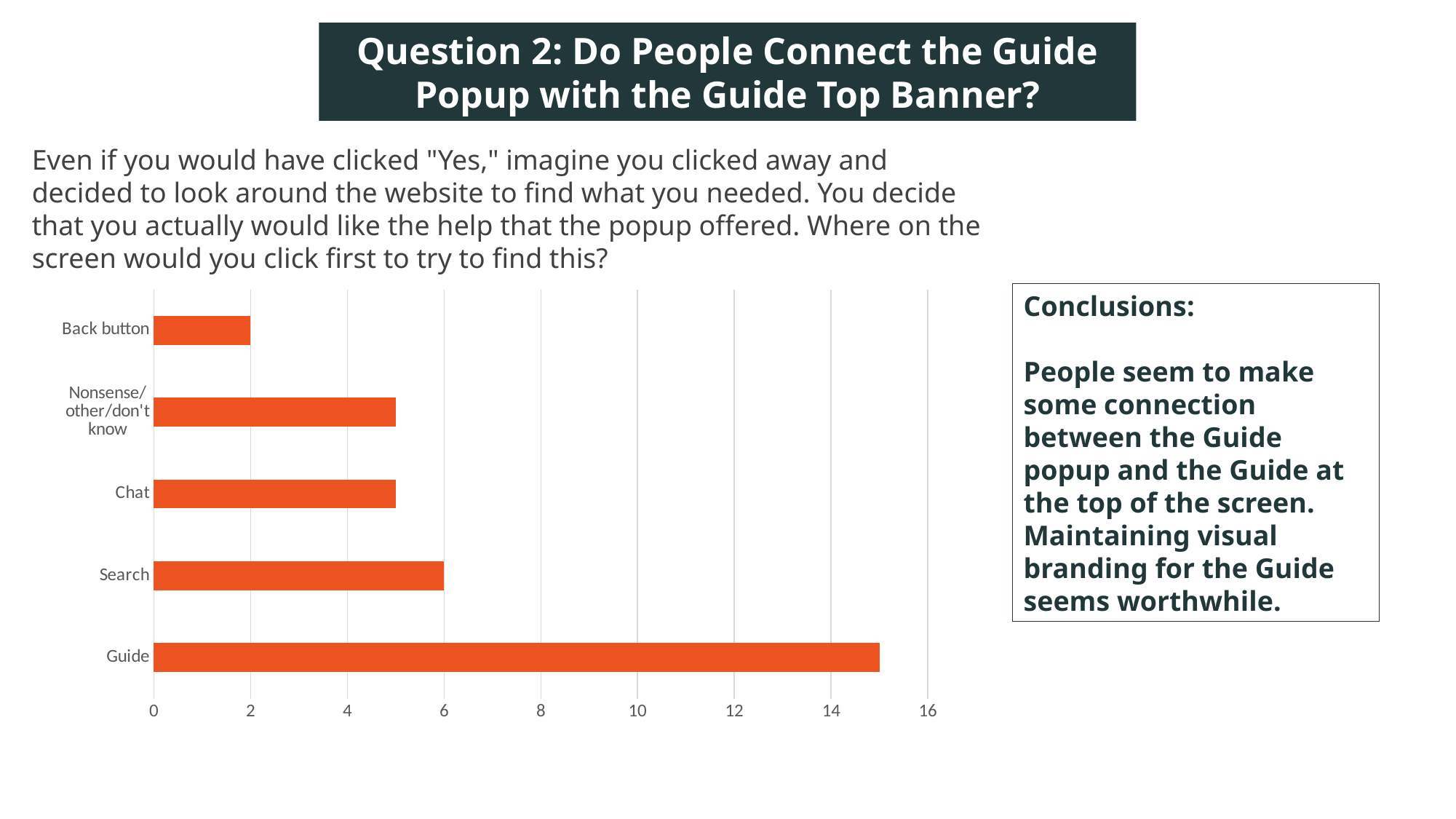
What is the difference between the values for Search and Back button? 4 Which category has the lowest value in the bar chart? Back button Is the value for Nonsense/other/don't know greater or less than 6? less Is the value for Guide greater or less than 14? greater What colour are the bars in the chart? orange Is the value for Chat greater or less than 4? greater What is the value for Search? 6 Which is larger, the value for Guide or the value for Search? Guide What kind of chart is shown on the slide? bar chart Which category has the highest value in the bar chart? Guide What is the value for Back button? 2 How many categories are shown in the bar chart? 5